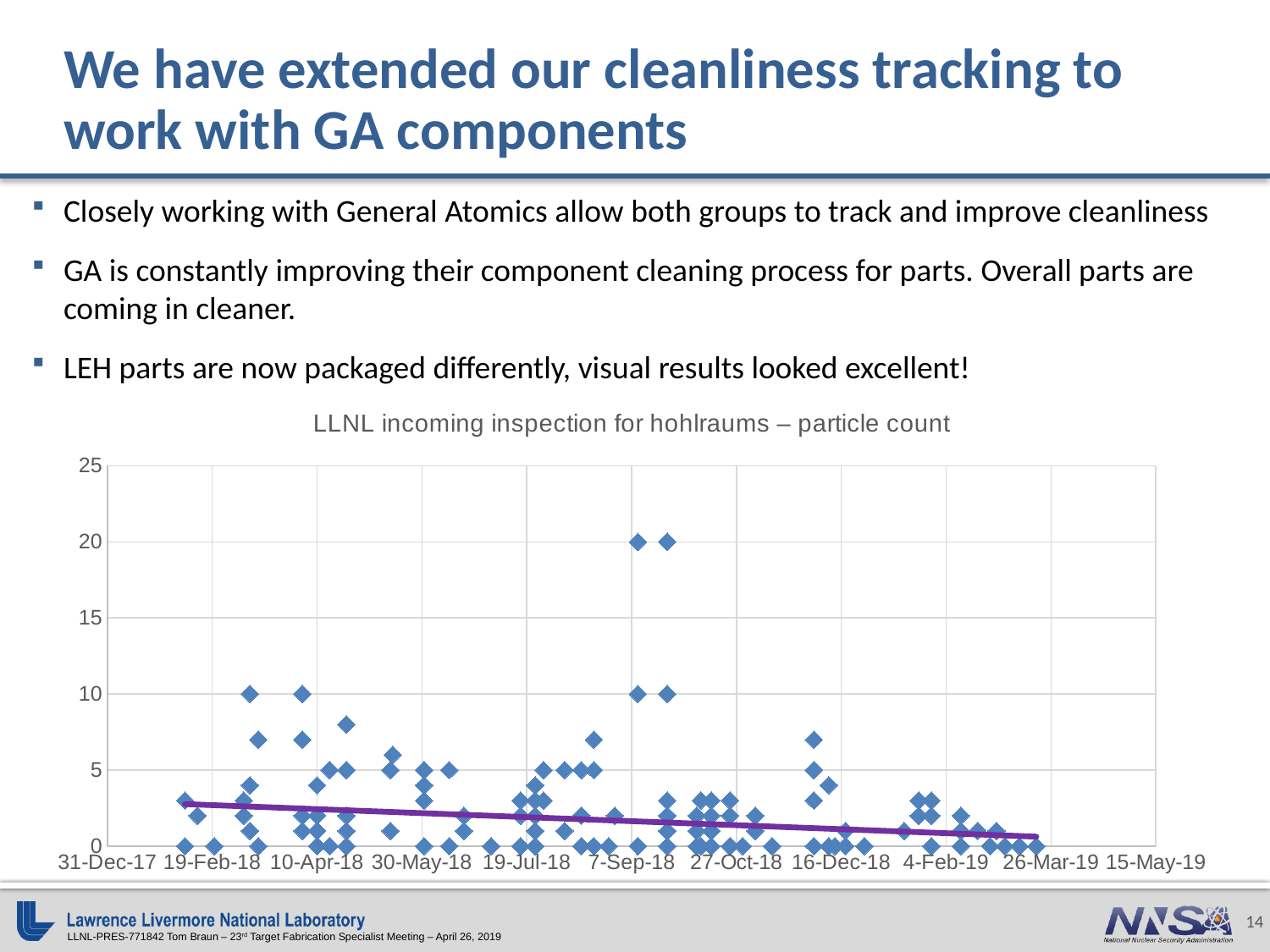
Are the highest points on the chart, near 7-Sep-18, greater or less than 15? greater What is the highest particle count value reached by any point on the chart? 20 What is the lowest particle count value shown by points on the chart? 0 Which is larger: the highest point near 7-Sep-18 or the highest point near 19-Feb-18? the highest point near 7-Sep-18 What is the maximum value shown on the vertical axis? 25 Does the trend line on the chart rise or fall from left to right? fall What is the title of the chart? LLNL incoming inspection for hohlraums – particle count Is the trend line value at the right end of the chart greater or less than 5? less Are the points near 16-Dec-18 greater or less than 10? less What kind of chart is shown on the slide? scatter chart What is the first date label on the horizontal axis? 31-Dec-17